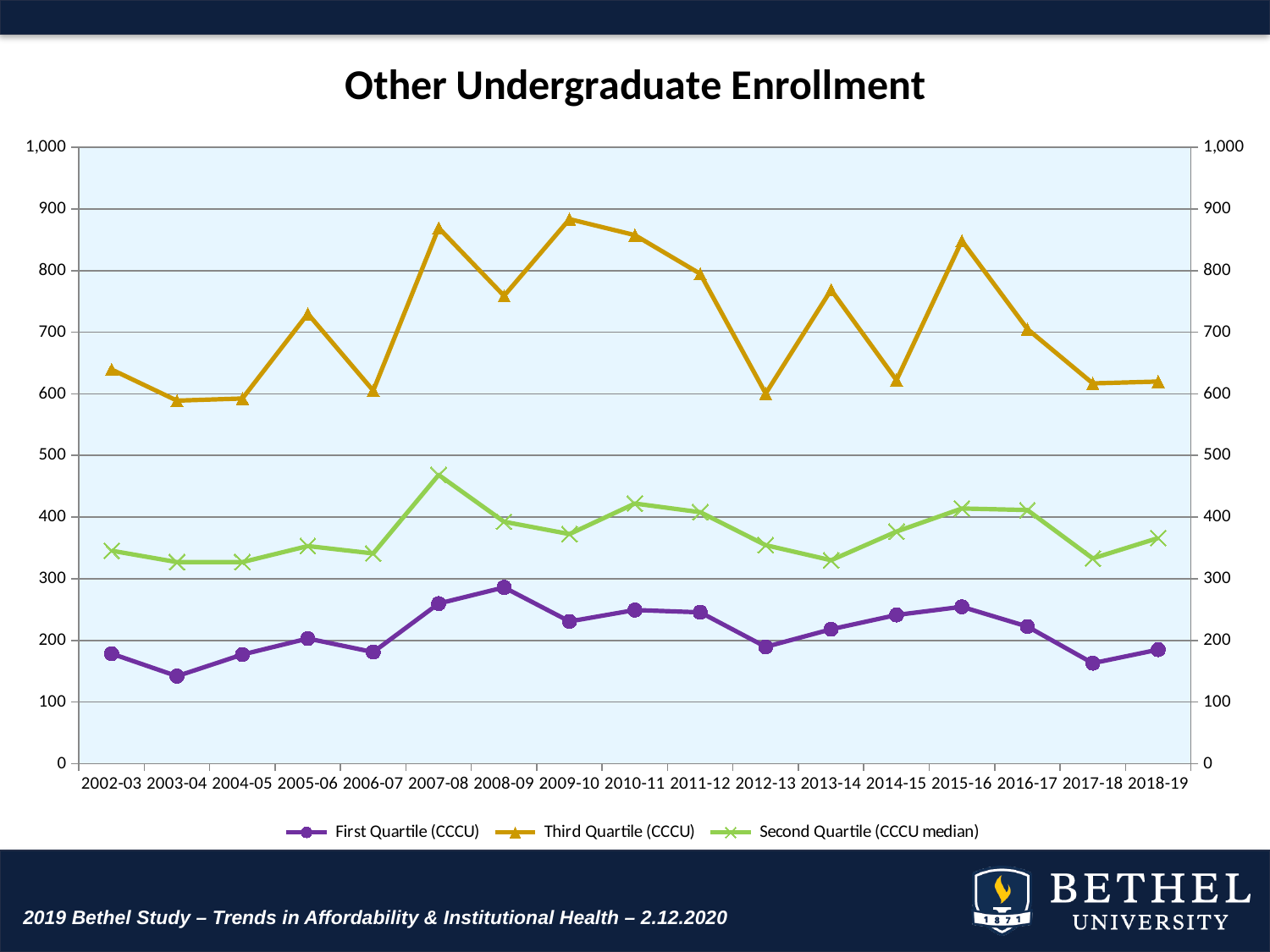
In which year does the Second Quartile (CCCU median) series reach its highest value? 2007-08 Is the First Quartile (CCCU) value for 2003-04 greater or less than 200? less How many academic years are plotted along the x axis? 17 What is the title of the chart? Other Undergraduate Enrollment Does the First Quartile (CCCU) series rise or fall from 2015-16 to 2017-18? fall What kind of chart is shown on the slide? line chart Which series is drawn in purple with circle markers? First Quartile (CCCU) In which year does the First Quartile (CCCU) series reach its lowest value? 2003-04 Which is larger for the Third Quartile (CCCU) series: the value for 2005-06 or the value for 2006-07? 2005-06 Is the Third Quartile (CCCU) value for 2007-08 greater or less than 800? greater In which year does the First Quartile (CCCU) series reach its highest value? 2008-09 How many series does the legend list? 3